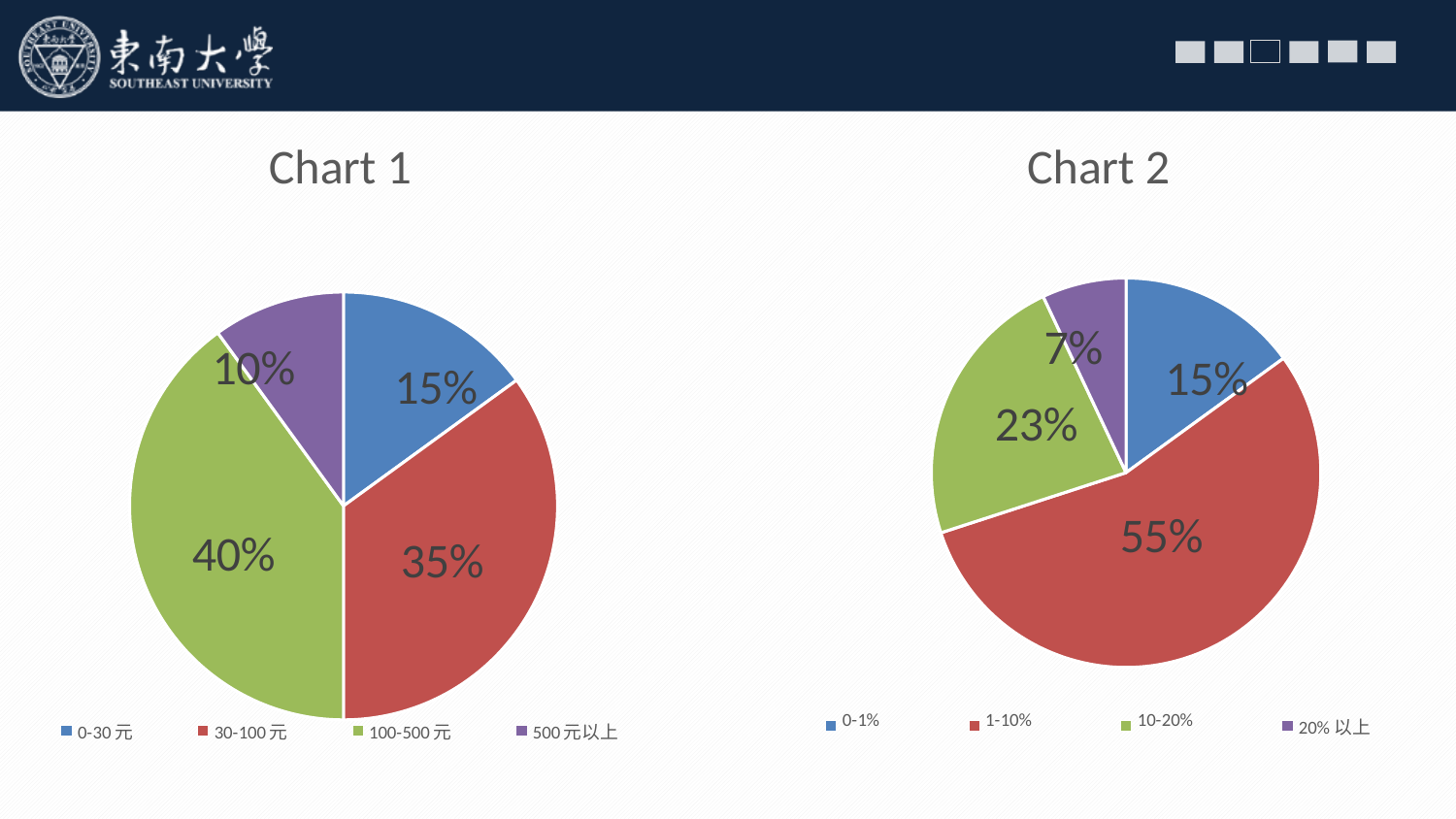
What kind of chart is Chart 2? Pie chart In Chart 1, what is the difference between the 100-500 元 slice and the 0-30 元 slice? 25% In Chart 1, what share does the 30-100 元 slice have? 35% In Chart 1, how many categories does the legend list? 4 In Chart 2, what share does the 1-10% slice have? 55% In Chart 2, what share does the 20% 以上 slice have? 7% In Chart 2, what is the difference between the 1-10% slice and the 10-20% slice? 32% In Chart 2, which category has the largest slice? 1-10% In Chart 1, which category has the smallest slice? 500 元以上 In Chart 1, which category has the largest slice? 100-500 元 In Chart 1, what share does the 100-500 元 slice have? 40% In Chart 2, which is larger, the 10-20% slice or the 0-1% slice? 10-20%